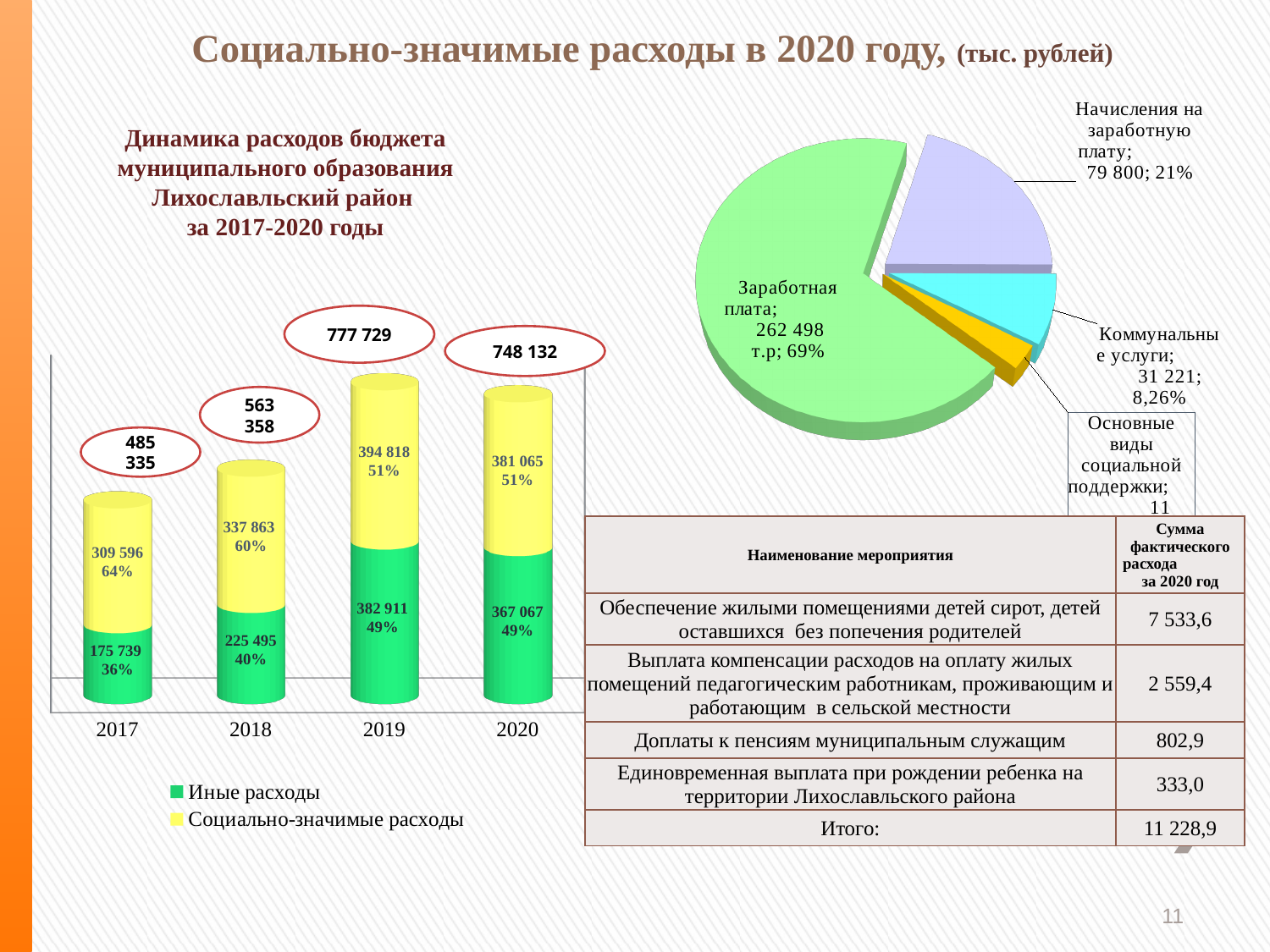
On the bar chart on the left, what is the value of 'Социально-значимые расходы' for 2019? 394 818 On the bar chart on the left, which year has the lowest total? 2017 On the bar chart on the left, what percentage share do 'Иные расходы' make up in 2018? 40% On the bar chart on the left, how many years are shown on the x axis? 4 On the bar chart on the left, which year has the highest total? 2019 On the pie chart on the right, what is the value and share of the 'Заработная плата' slice? 262 498 т.р; 69% On the bar chart on the left, what is the difference between 'Социально-значимые расходы' in 2018 and in 2017? 28 267 On the pie chart on the right, which is larger: 'Начисления на заработную плату' or 'Коммунальные услуги'? Начисления на заработную плату On the bar chart on the left, what is the value of 'Иные расходы' for 2017? 175 739 On the bar chart on the left, what is the total shown above the 2020 bar? 748 132 What kind of chart is the chart on the left of the slide? Stacked bar chart On the bar chart on the left, how many series does the legend list? 2